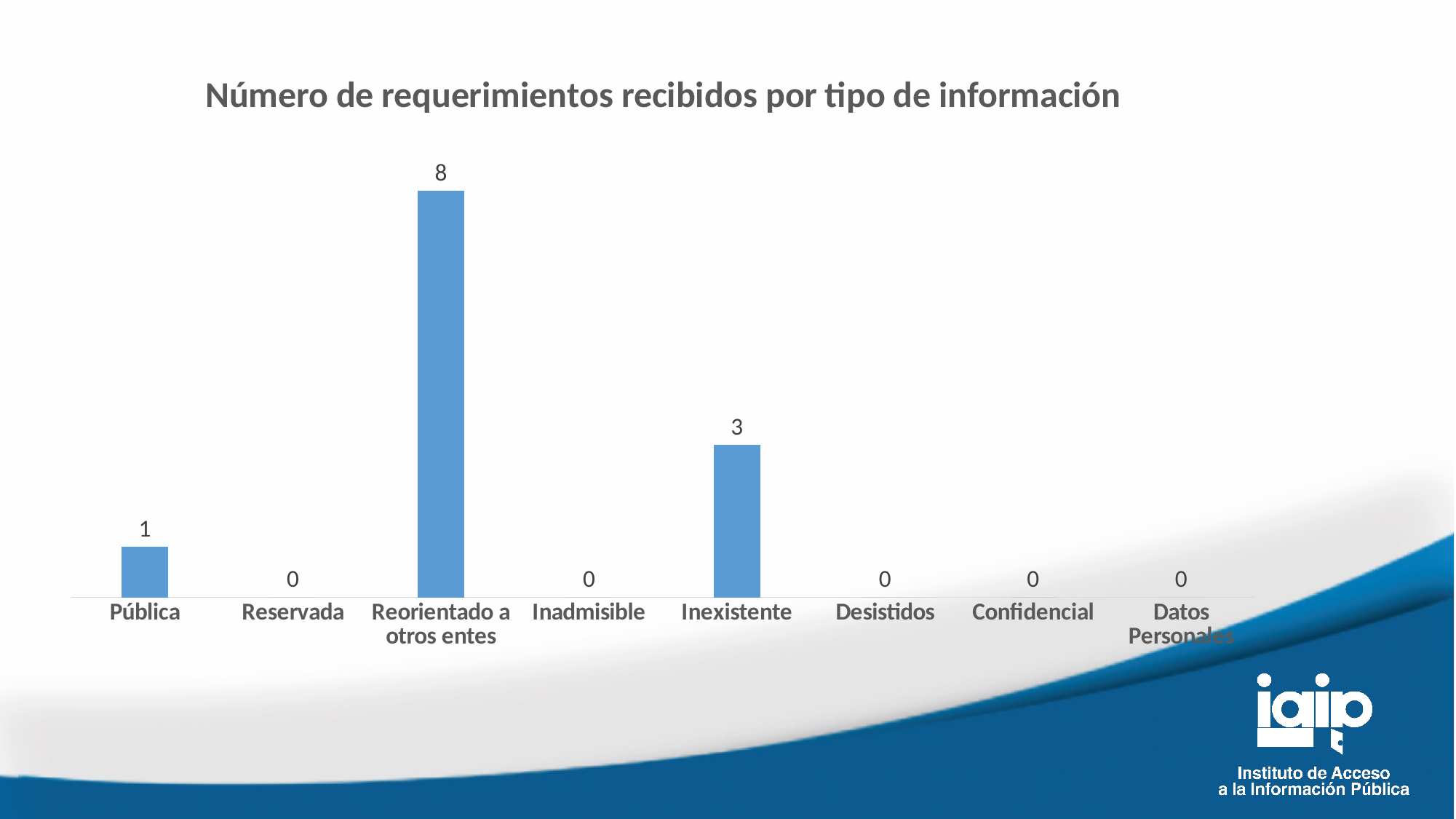
What is the value for Reorientado a otros entes? 8 What is the value for Reservada? 0 What is the value for Pública? 1 Which category has the highest value? Reorientado a otros entes What is the value for Inexistente? 3 Which is larger, the value for Pública or the value for Inexistente? Inexistente What is the title of the chart? Número de requerimientos recibidos por tipo de información How many categories are shown on the x axis? 8 How many categories have a value of 0? 5 What is the difference between the values for Inexistente and Pública? 2 What is the difference between the values for Reorientado a otros entes and Inexistente? 5 What kind of chart is shown on the slide? Bar chart